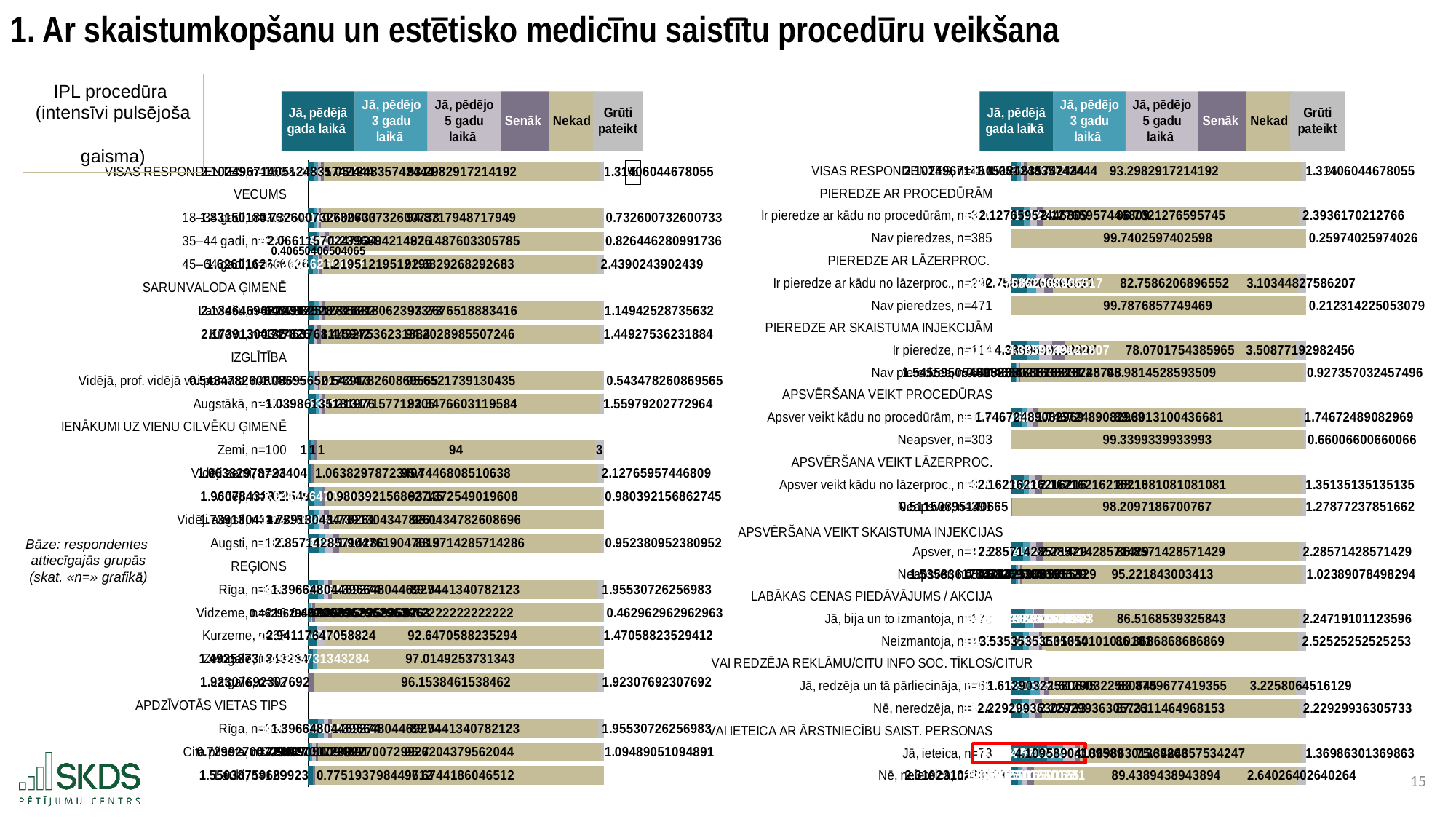
How many series does the legend above the left chart list? 6 In the left chart, what is the value of 'Grūti pateikt' for the row 'Zemi, n=100'? 3 In the right chart, which row has the larger 'Nekad' value: 'Nav pieredzes, n=385' or 'Ir pieredze, n=114'? Nav pieredzes, n=385 In the right chart, what is the 'Nekad' value for 'Ir pieredze, n=114' under 'Pieredze ar skaistuma injekcijām'? 78.0701754385965 In the right chart, what is the 'Grūti pateikt' value for 'Nē, neieteica'? 2.64026402640264 What kind of chart is used on the left side of the slide? bar chart In the right chart, what is the 'Nekad' value for 'Neapsver, n=303'? 99.3399339933993 In the left chart, what is the value of 'Nekad' for the row 'Zemi, n=100'? 94 In the right chart, what is the 'Grūti pateikt' value for 'Nav pieredzes, n=471'? 0.212314225053019 In the left chart, what is the 'Nekad' value for the Kurzeme row? 92.6470588235294 What is the name of the last series in the legend of the right chart? Grūti pateikt In the right chart, what is the 'Nekad' value for 'Nav pieredzes, n=385'? 99.7402597402598